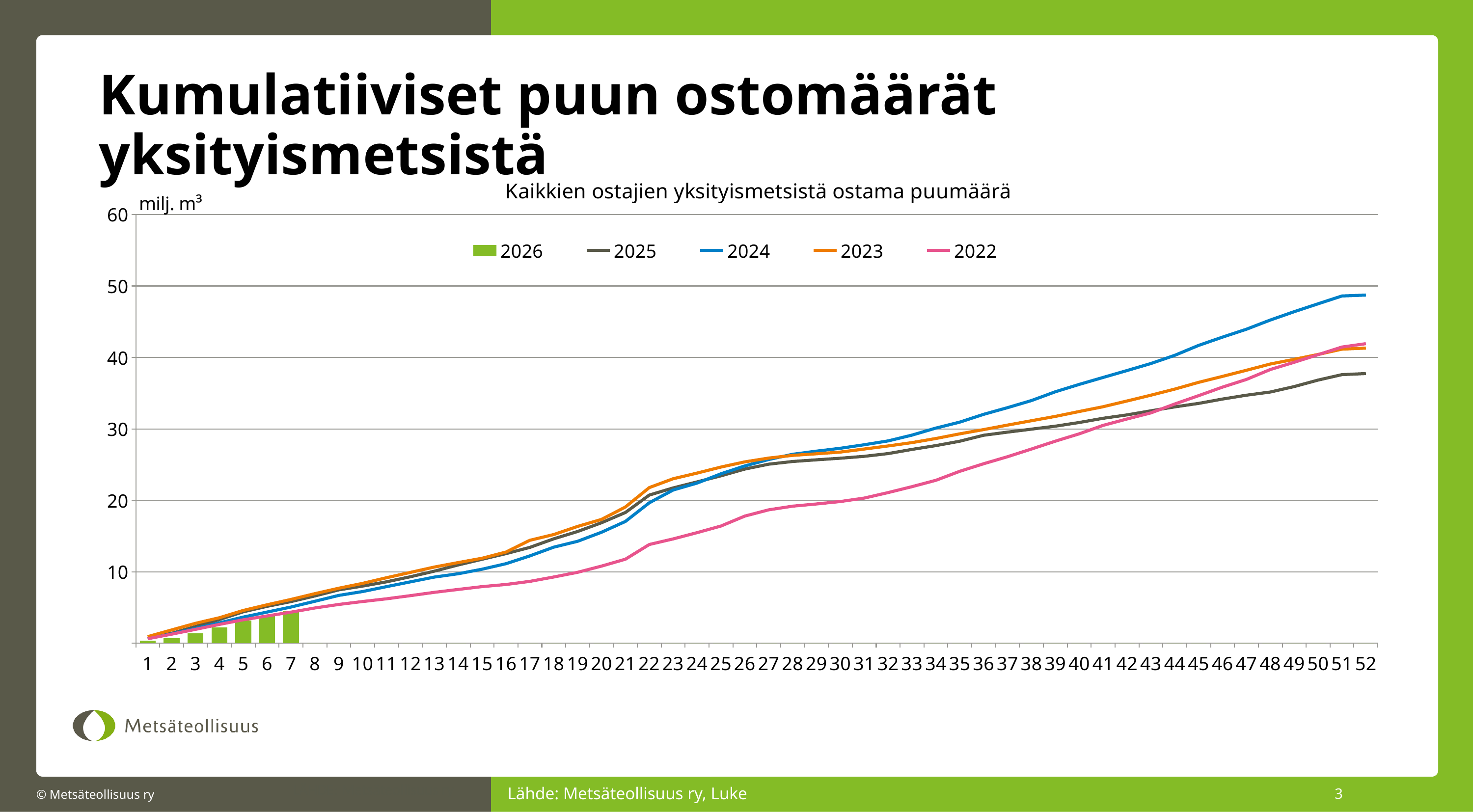
Is the value for 2025 at week 52 greater or less than 40? less What kind of chart is shown on the slide? A combination of a line chart and a bar chart How many weeks are shown on the x axis? 52 At week 52, which is larger, the value for 2024 or the value for 2022? 2024 Do the line series rise or fall as the week number increases? Rise For how many weeks are bars plotted for the 2026 series? 7 Is the value for 2022 at week 26 greater or less than 20? less Which series has the lowest value at week 52? 2025 What unit is shown on the y axis of the chart? milj. m³ Which series has the highest value at week 52? 2024 How many series does the legend list? 5 Is the value for 2024 at week 52 greater or less than 40? greater